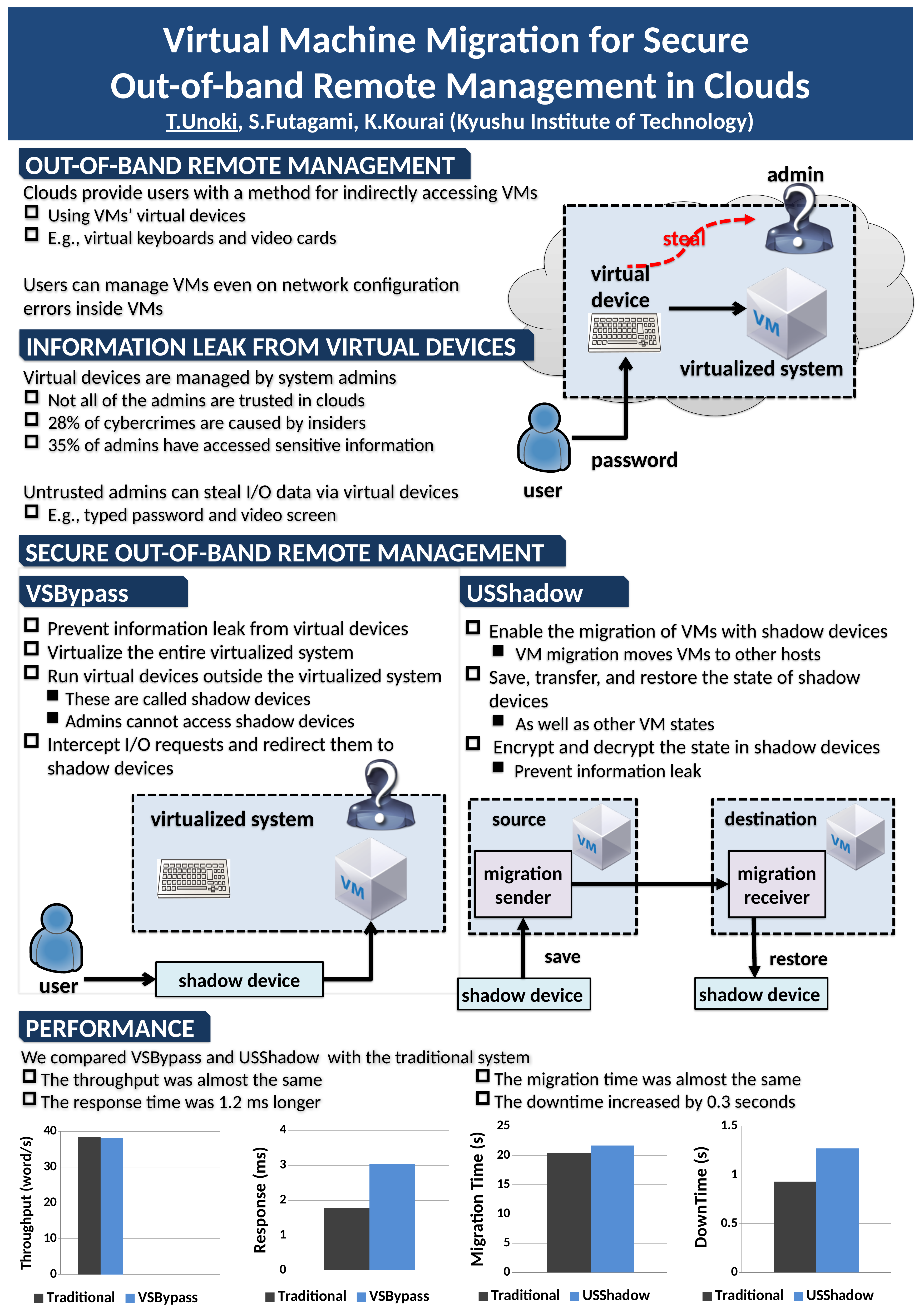
In the Migration Time (s) chart, which is larger, Traditional or USShadow? USShadow How many series does the legend of the Migration Time (s) chart list? 2 What kind of chart is the Throughput (word/s) chart? bar chart In the Throughput (word/s) chart, is the value for Traditional greater or less than 30? greater In the DownTime (s) chart, which is larger, Traditional or USShadow? USShadow In the Response (ms) chart, which is larger, Traditional or VSBypass? VSBypass What are the two legend entries of the Response (ms) chart? Traditional and VSBypass In the Migration Time (s) chart, is the value for Traditional greater or less than 15? greater In the Response (ms) chart, is the value for VSBypass greater or less than 2? greater